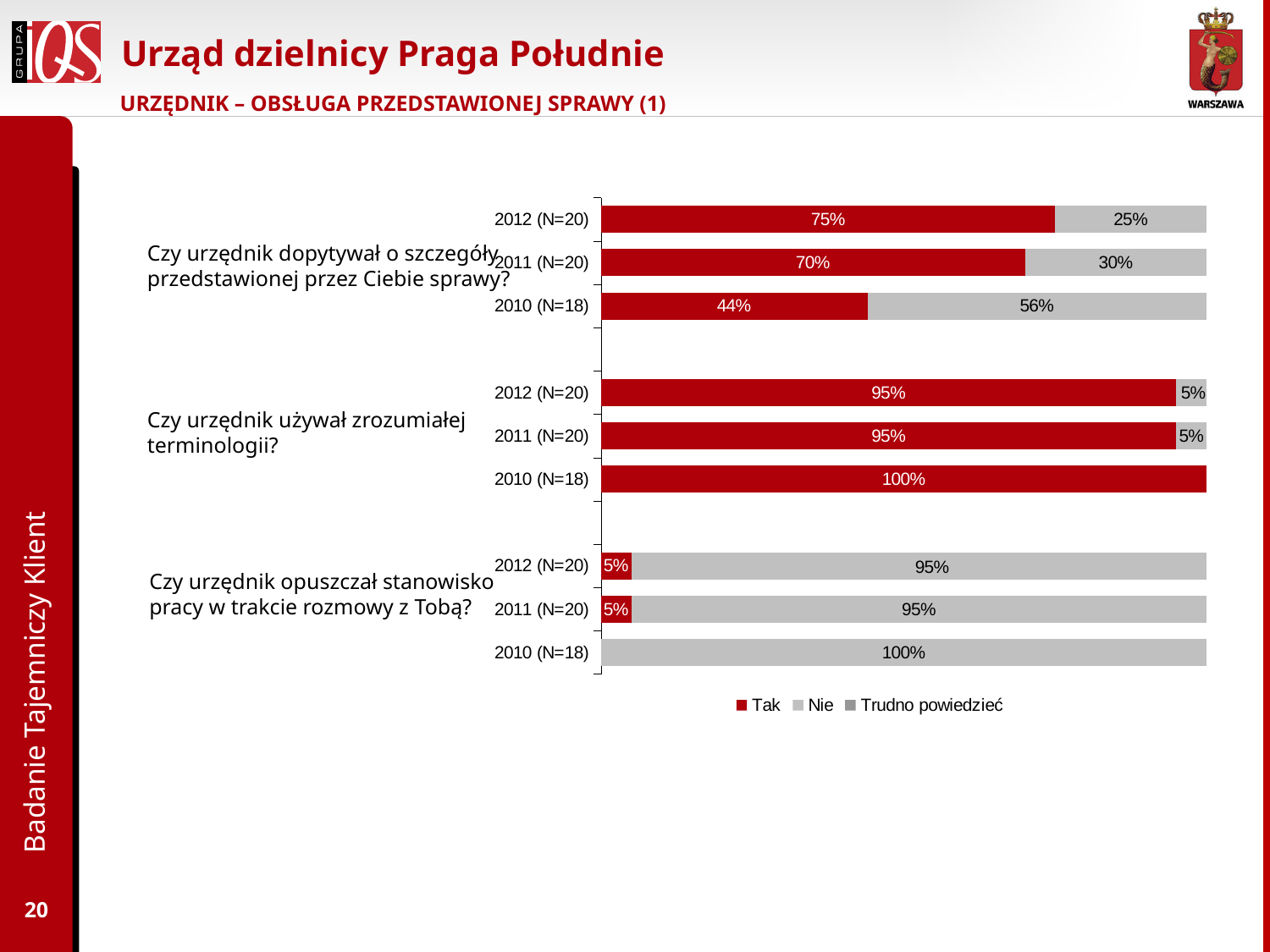
For the question 'Czy urzędnik dopytywał o szczegóły przedstawionej przez Ciebie sprawy?', which year has the lowest 'Tak' value? 2010 (N=18) For the question 'Czy urzędnik dopytywał o szczegóły przedstawionej przez Ciebie sprawy?', what is the difference between the 'Tak' values for 2012 (N=20) and 2011 (N=20)? 5% For the question 'Czy urzędnik dopytywał o szczegóły przedstawionej przez Ciebie sprawy?', does the 'Tak' value rise or fall from 2010 to 2012? rise What type of chart is shown on the slide? stacked bar chart What is the 'Tak' value for 2010 (N=18) for the question 'Czy urzędnik używał zrozumiałej terminologii?' 100% How many bars (year rows) are plotted in the chart in total? 9 What is the 'Nie' value for 2010 (N=18) for the question 'Czy urzędnik dopytywał o szczegóły przedstawionej przez Ciebie sprawy?' 56% What is the 'Tak' value for 2012 (N=20) for the question 'Czy urzędnik dopytywał o szczegóły przedstawionej przez Ciebie sprawy?' 75% For the question 'Czy urzędnik dopytywał o szczegóły przedstawionej przez Ciebie sprawy?', is the 'Tak' value for 2011 (N=20) larger or smaller than the 'Tak' value for 2010 (N=18)? larger How many series does the legend list? 3 What is the 'Nie' value for 2011 (N=20) for the question 'Czy urzędnik opuszczał stanowisko pracy w trakcie rozmowy z Tobą?' 95% What are the legend entries of the chart? Tak, Nie, Trudno powiedzieć